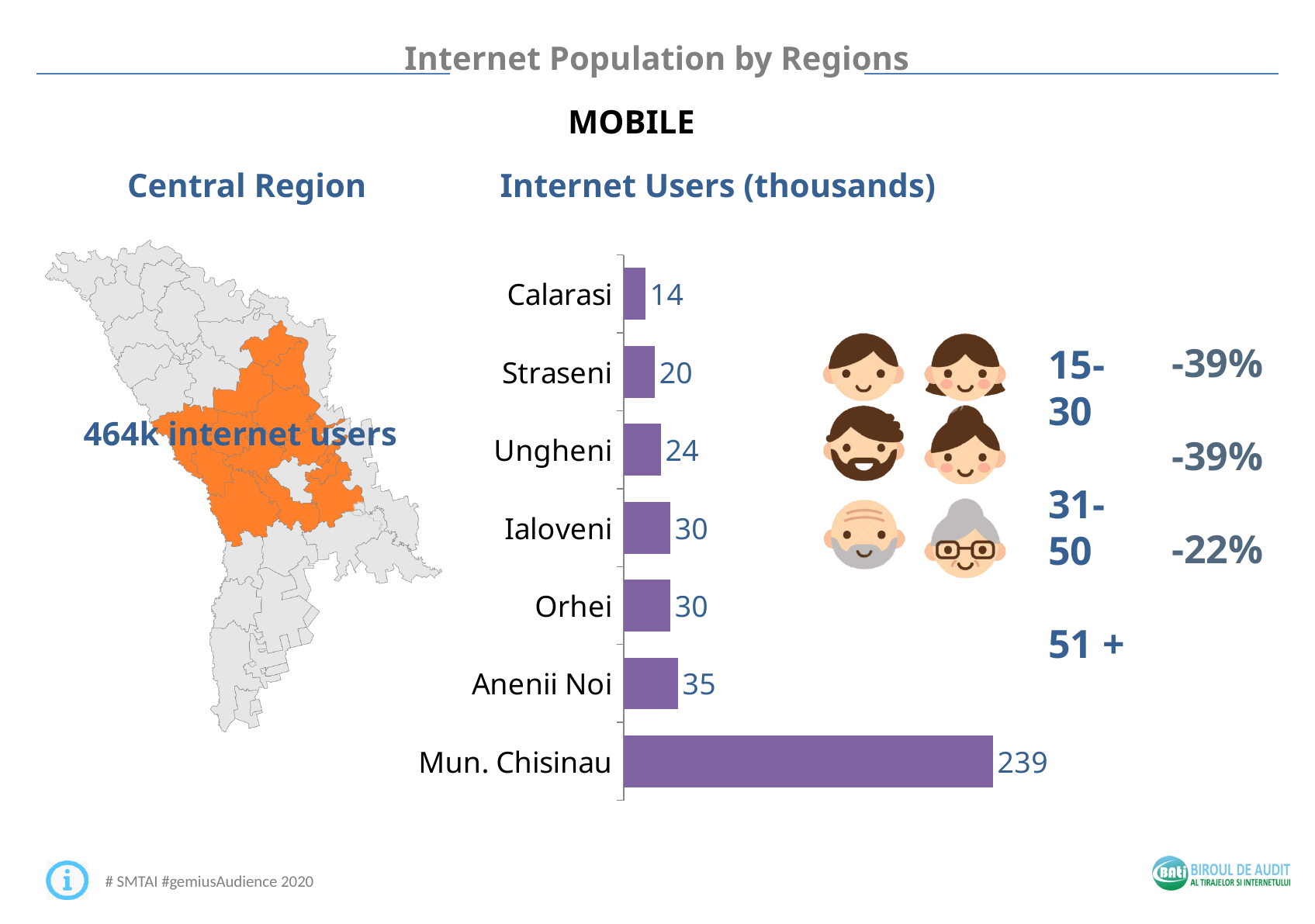
How many categories are shown in the Internet Users (thousands) chart? 7 What is the value for Mun. Chisinau in the Internet Users (thousands) chart? 239 Which is larger in the Internet Users (thousands) chart, Ungheni or Anenii Noi? Anenii Noi What is the value for Anenii Noi in the Internet Users (thousands) chart? 35 Which category has the highest value in the Internet Users (thousands) chart? Mun. Chisinau What is the value for Calarasi in the Internet Users (thousands) chart? 14 What is the difference between the values for Mun. Chisinau and Anenii Noi in the Internet Users (thousands) chart? 204 What kind of chart is the Internet Users (thousands) chart? bar chart What is the title of the chart on the slide? Internet Users (thousands) What is the difference between the values for Straseni and Calarasi in the Internet Users (thousands) chart? 6 What is the value for Ungheni in the Internet Users (thousands) chart? 24 Which category has the lowest value in the Internet Users (thousands) chart? Calarasi